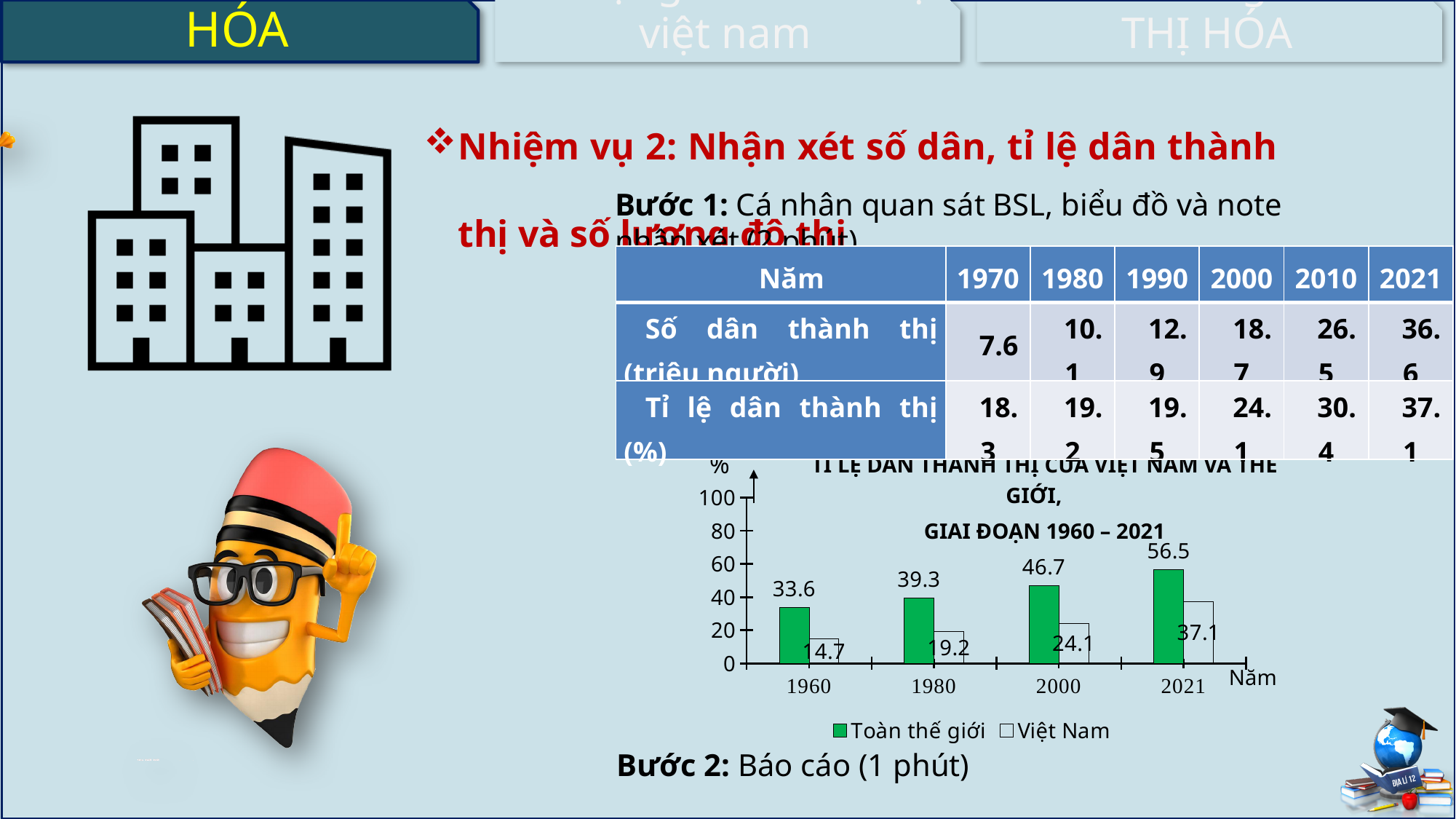
What is the difference between the Toàn thế giới and Việt Nam values in 2021? 19.4 What is the value for Toàn thế giới in 2000? 46.7 Which is larger in 2000: the Toàn thế giới value or the Việt Nam value? Toàn thế giới In which year is the Toàn thế giới value highest? 2021 Do the Việt Nam values rise or fall from 1960 to 2021? rise How many series does the chart legend list? 2 What is the value for Việt Nam in 1980? 19.2 What is the value for Việt Nam in 2021? 37.1 What kind of chart is shown on the slide? bar chart What is the value for Toàn thế giới in 1960? 33.6 In which year is the Việt Nam value lowest? 1960 How many years are shown on the x axis of the chart? 4